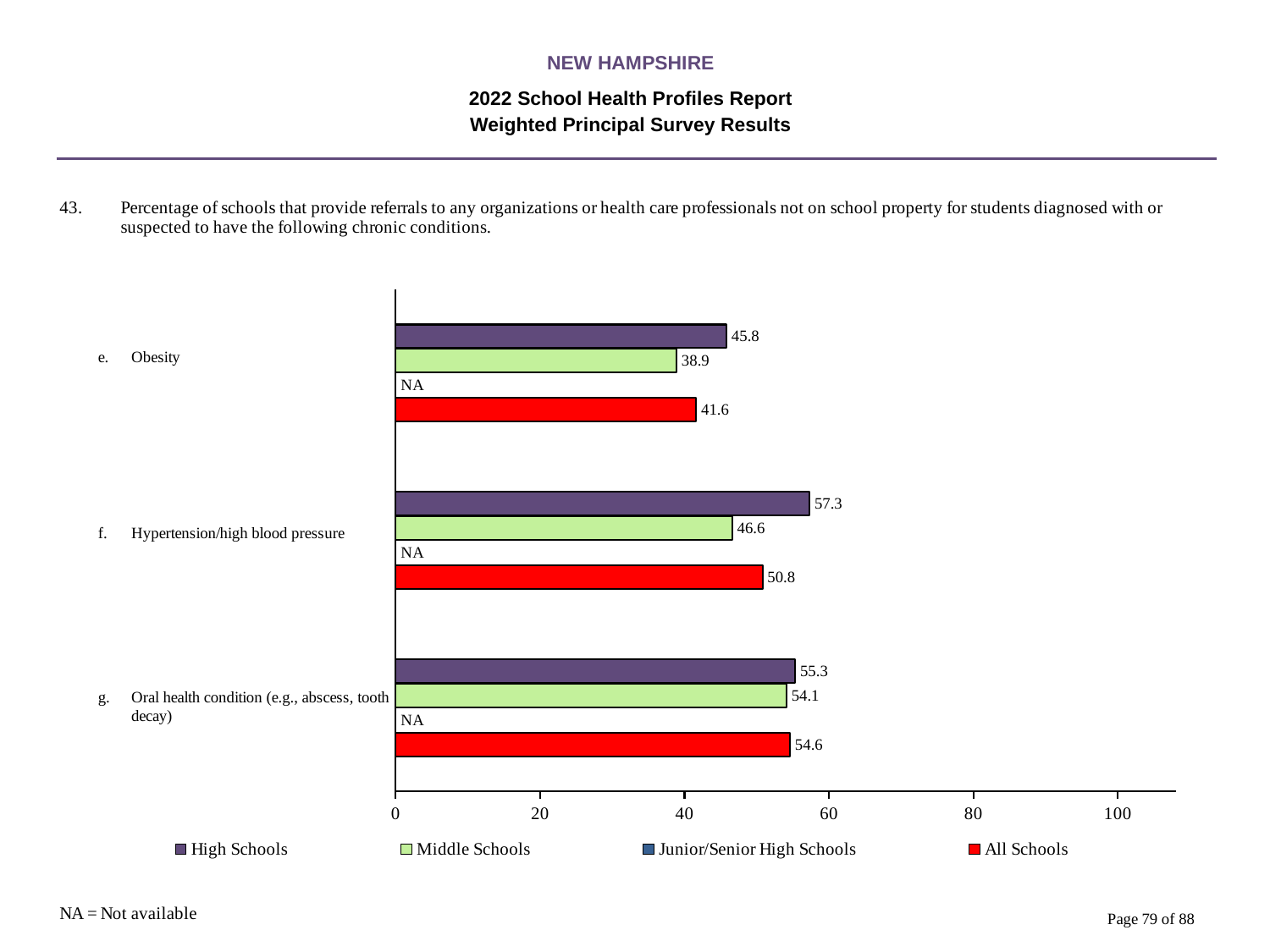
What is the value for Middle Schools for Hypertension/high blood pressure? 46.6 What is the value for High Schools for Obesity? 45.8 What is shown for Junior/Senior High Schools for Obesity? NA What kind of chart is shown on the slide? bar chart What is the value for All Schools for Oral health condition (e.g., abscess, tooth decay)? 54.6 Is the All Schools value for Hypertension/high blood pressure greater or less than 40? greater How many series does the legend list? 4 How many chronic conditions are shown on the chart? 3 Which condition has the lowest value for Middle Schools? Obesity Which is larger for Obesity: the High Schools value or the All Schools value? High Schools What is the difference between the High Schools and Middle Schools values for Hypertension/high blood pressure? 10.7 Which condition has the highest value for High Schools? Hypertension/high blood pressure